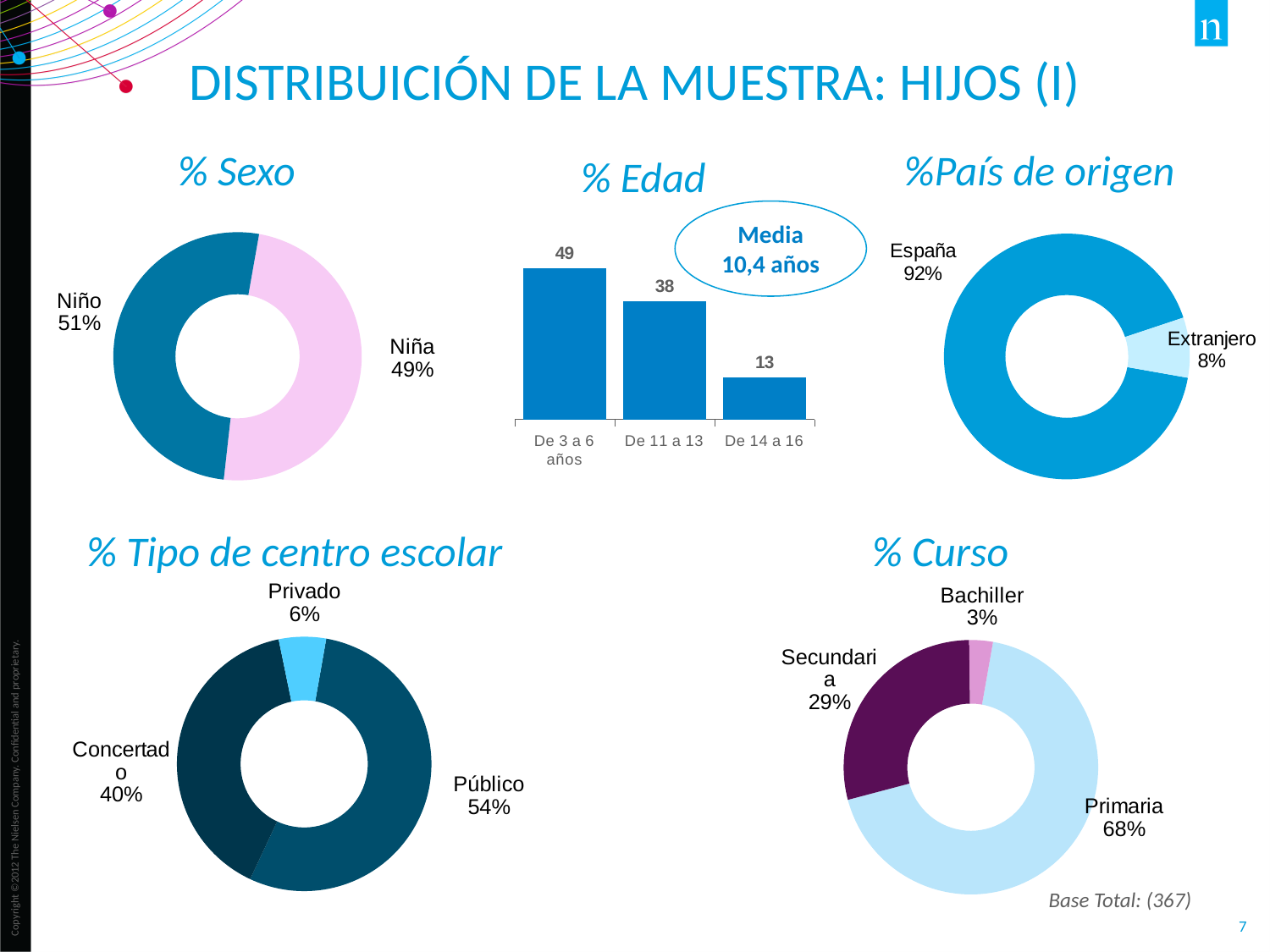
In the '% Curso' chart, how many categories are shown? 3 In the '% Tipo de centro escolar' chart, what is the difference between Público and Concertado? 14% In the '% Curso' chart, which is larger, Secundaria or Bachiller? Secundaria What kind of chart is the '% Edad' chart? bar chart In the '% Edad' chart, which age group has the lowest value? De 14 a 16 In the '% Edad' chart, what is the value for 'De 11 a 13'? 38 In the '% Tipo de centro escolar' chart, which category has the largest share? Público In the '% Edad' chart, do the values rise or fall from left to right along the x axis? fall In the '%País de origen' chart, what is the value for Extranjero? 8% In the '% Sexo' chart, what is the value for Niño? 51% In the '% Edad' chart, which age group has the highest value? De 3 a 6 años In the '% Edad' chart, what is the difference between the values for 'De 3 a 6 años' and 'De 14 a 16'? 36